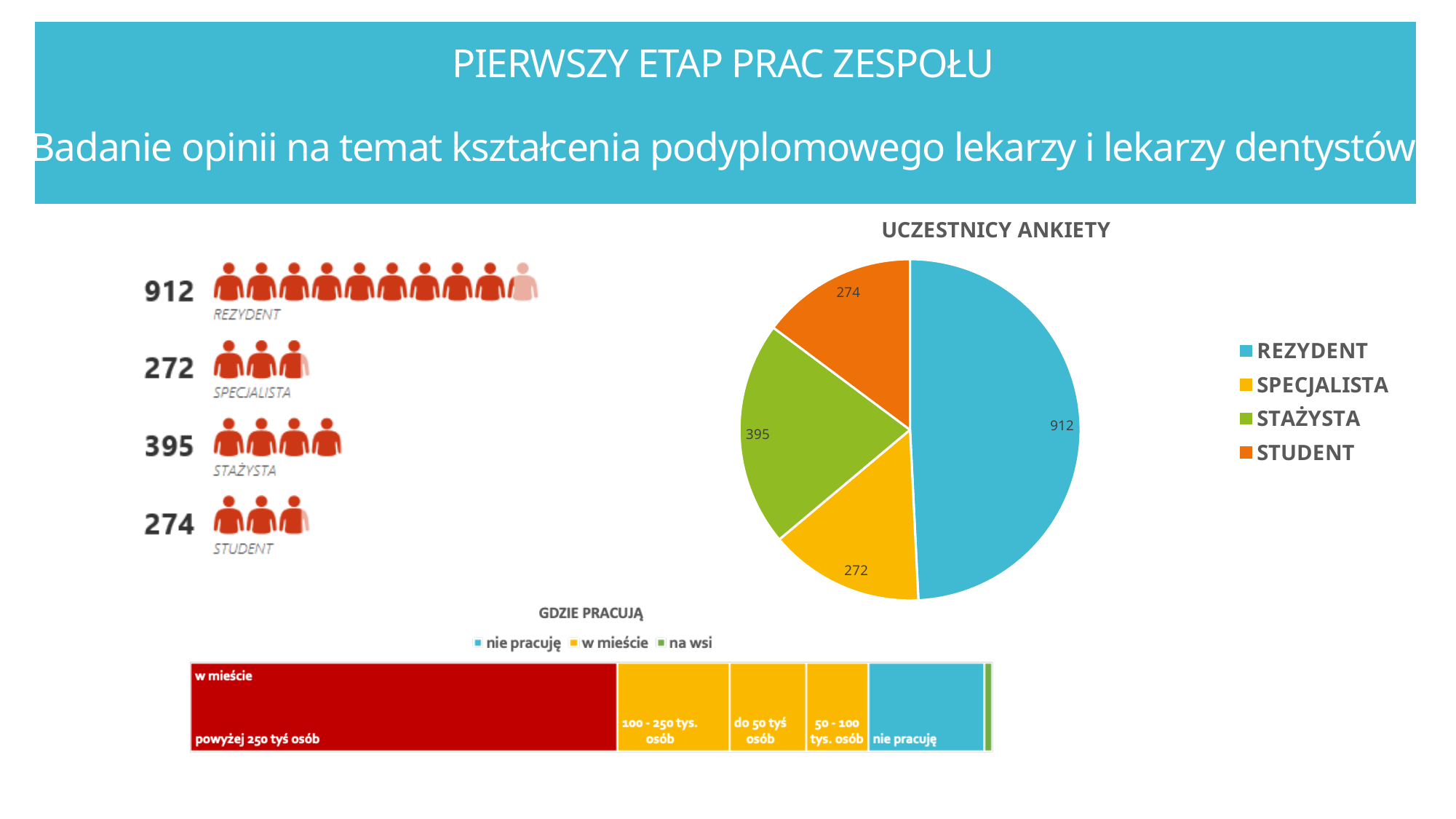
How many entries does the legend of the 'GDZIE PRACUJĄ' chart list? 3 In the pie chart 'UCZESTNICY ANKIETY', what is the value for REZYDENT? 912 What kind of chart is 'UCZESTNICY ANKIETY'? pie chart In the pie chart 'UCZESTNICY ANKIETY', what is the difference between the values for REZYDENT and SPECJALISTA? 640 In the pie chart 'UCZESTNICY ANKIETY', what is the value for STUDENT? 274 How many categories does the pie chart 'UCZESTNICY ANKIETY' show? 4 In the pie chart 'UCZESTNICY ANKIETY', what is the difference between the values for STAŻYSTA and STUDENT? 121 In the pie chart 'UCZESTNICY ANKIETY', what is the value for STAŻYSTA? 395 In the pie chart 'UCZESTNICY ANKIETY', what is the value for SPECJALISTA? 272 In the pie chart 'UCZESTNICY ANKIETY', which is larger, the value for STAŻYSTA or the value for STUDENT? STAŻYSTA In the pie chart 'UCZESTNICY ANKIETY', which category has the smallest value? SPECJALISTA In the pie chart 'UCZESTNICY ANKIETY', which category has the largest value? REZYDENT